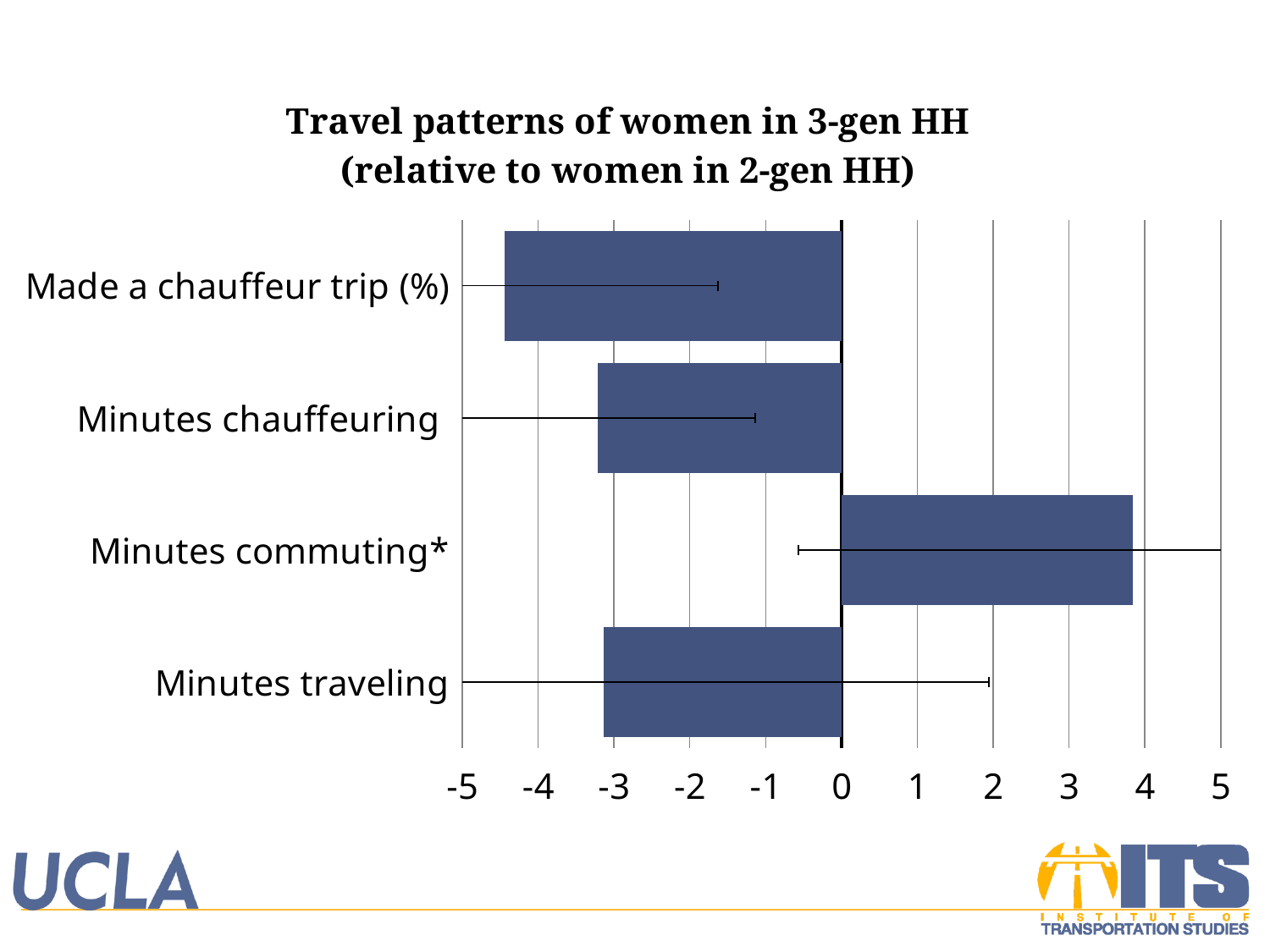
What are the minimum and maximum values shown on the horizontal axis? -5 and 5 Is the value for Made a chauffeur trip (%) greater or less than -4? less Is the value for Minutes chauffeuring greater or less than -2? less What is the title of the chart? Travel patterns of women in 3-gen HH (relative to women in 2-gen HH) Which is larger, the value for Minutes commuting* or the value for Minutes traveling? Minutes commuting* What kind of chart is shown on the slide? bar chart Is the value for Minutes traveling greater or less than -2? less How many categories are plotted in the chart? 4 Which category has the highest value? Minutes commuting* Which category has the lowest value? Made a chauffeur trip (%) Which is larger, the value for Minutes chauffeuring or the value for Made a chauffeur trip (%)? Minutes chauffeuring